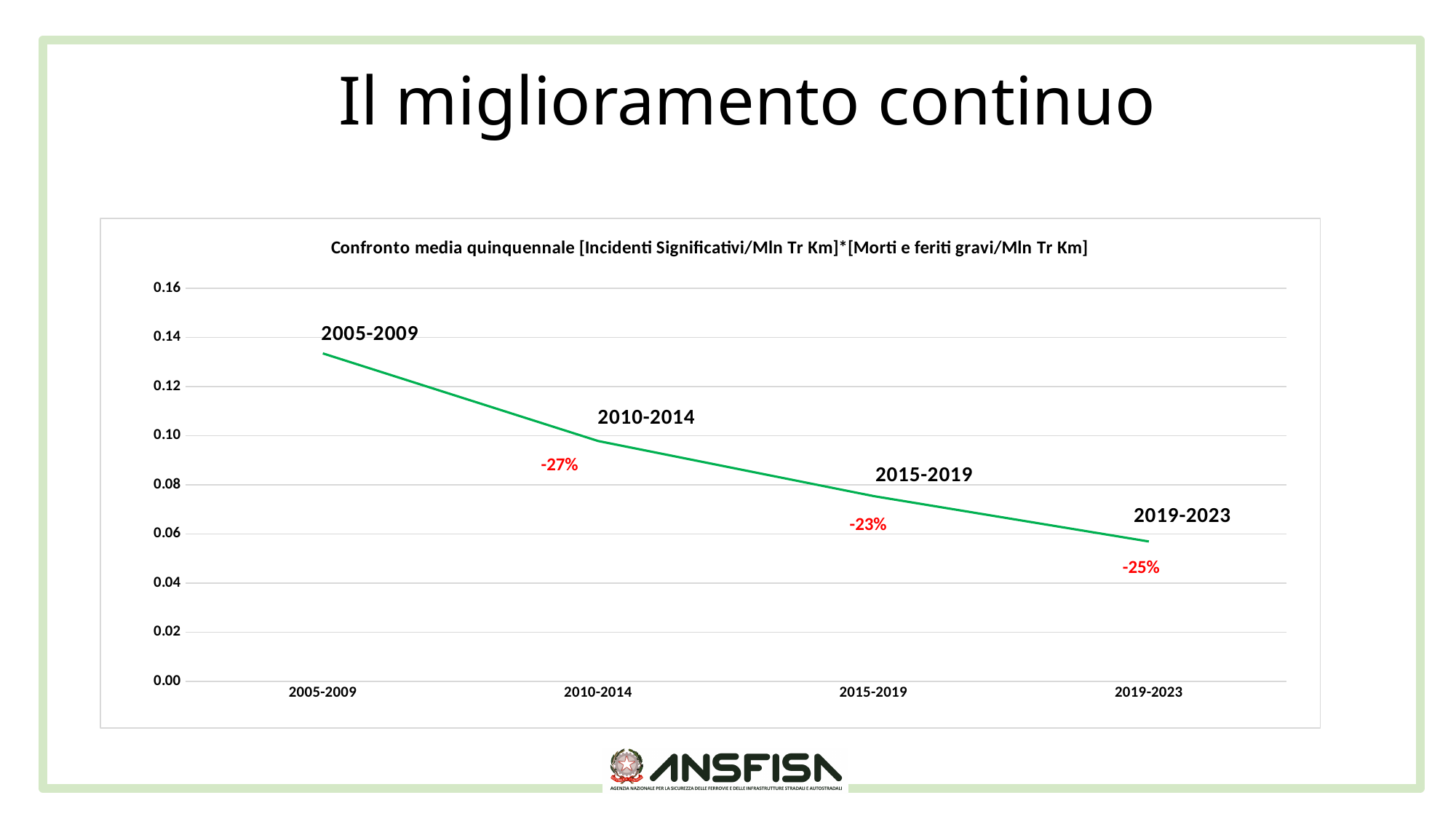
Which period has the highest value? 2005-2009 Is the value for 2010-2014 greater or less than 0.08? greater What percentage change is labelled in red next to the 2019-2023 point? -25% Is the value for 2005-2009 greater or less than 0.12? greater What percentage change is labelled in red next to the 2010-2014 point? -27% What kind of chart is shown on the slide? line chart Do the values rise or fall from 2005-2009 to 2019-2023? fall Is the value for 2019-2023 greater or less than 0.04? greater How many five-year periods are plotted on the x axis? 4 Which period has the lowest value? 2019-2023 Which is larger, the value for 2010-2014 or the value for 2015-2019? 2010-2014